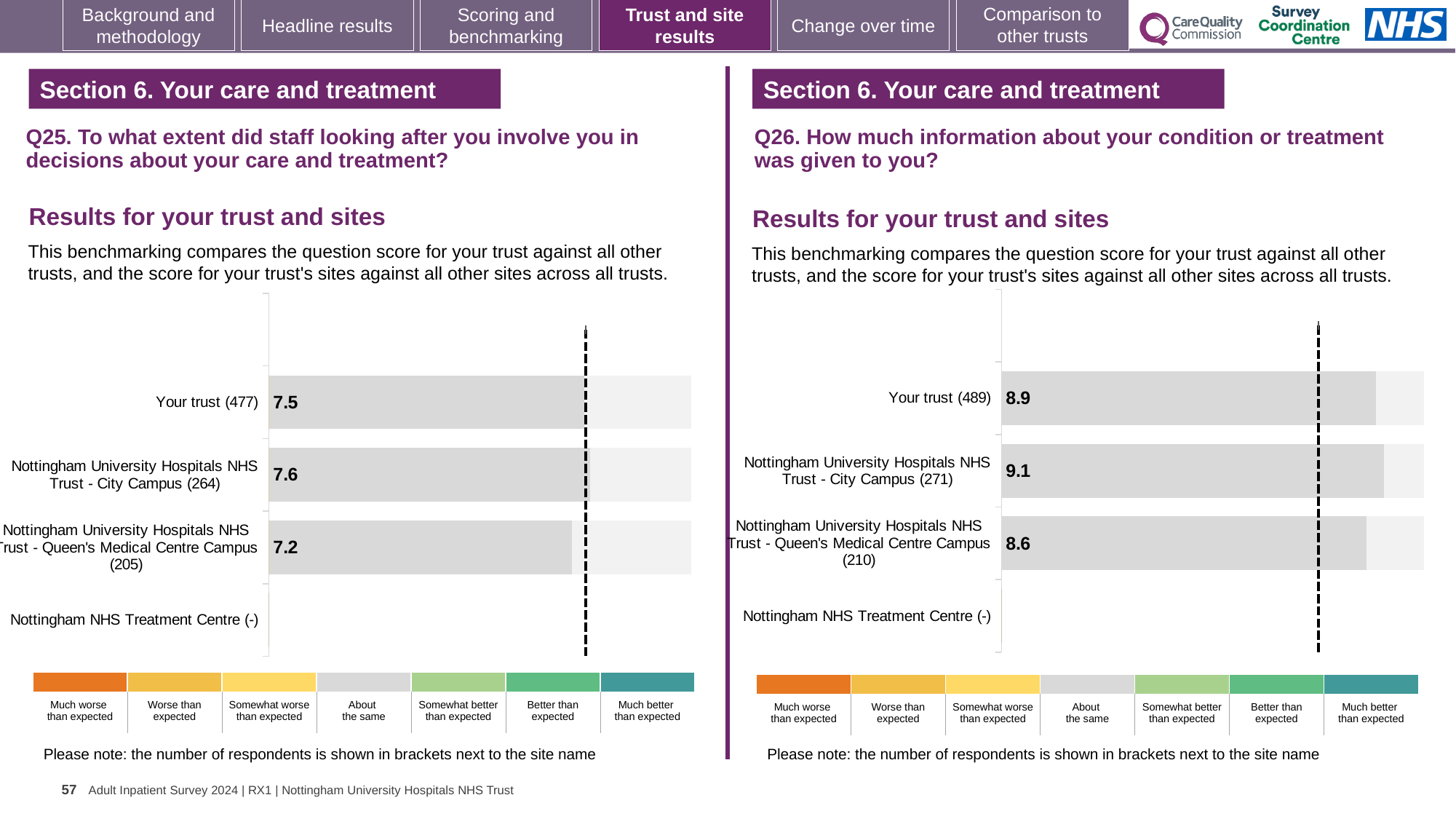
In the Q25 chart on the left, which site or trust has the highest score? Nottingham University Hospitals NHS Trust - City Campus (264) In the Q26 chart on the right, which site or trust has the lowest score? Nottingham University Hospitals NHS Trust - Queen's Medical Centre Campus (210) In the Q26 chart on the right, what is the score for Nottingham University Hospitals NHS Trust - City Campus (271)? 9.1 In the Q26 chart on the right, which is larger: the score for Your trust or the score for Queen's Medical Centre Campus? Your trust In the Q26 chart on the right, what is the score for Your trust (489)? 8.9 In the Q25 chart on the left, how many sites or trusts are listed on the vertical axis? 4 What type of chart is used for the Q26 results on the right? Bar chart In the Q25 chart on the left, what is the score for Your trust (477)? 7.5 How many respondents are shown in brackets for Nottingham NHS Treatment Centre in the Q25 chart on the left? - In the Q26 chart on the right, what is the difference between the City Campus score and the Queen's Medical Centre Campus score? 0.5 In the Q25 chart on the left, what is the score for Nottingham University Hospitals NHS Trust - Queen's Medical Centre Campus (205)? 7.2 In the Q25 chart on the left, what is the difference between the City Campus score and the Queen's Medical Centre Campus score? 0.4